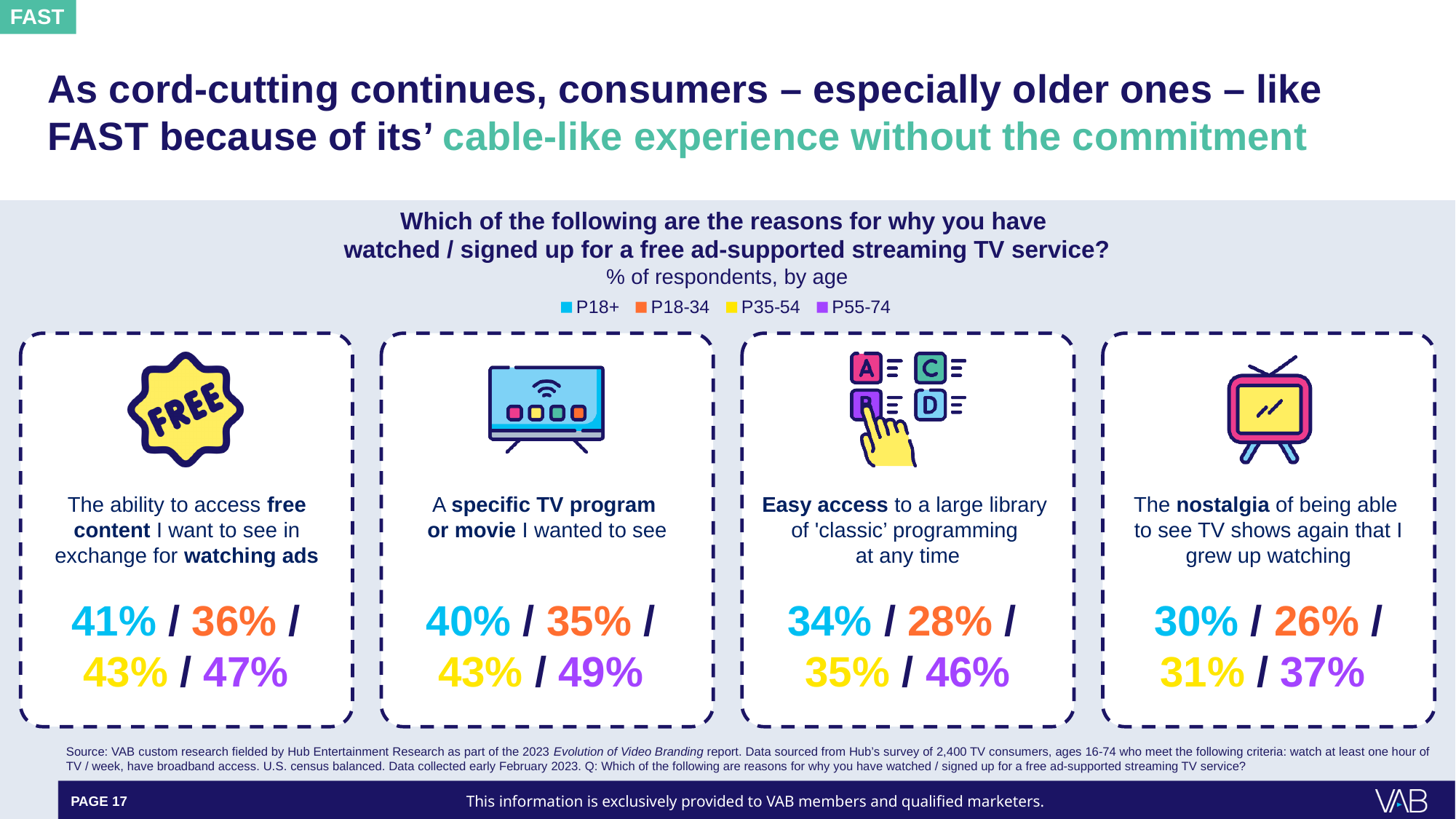
For the 'easy access to classic programming' reason, which age group has a higher percentage: P35-54 or P55-74? P55-74 Among P55-74 respondents, which reason has the highest percentage? A specific TV program or movie I wanted to see How many reasons for watching or signing up for a free ad-supported streaming TV service are shown? 4 Which age group is represented by the purple colour in the legend? P55-74 What percentage of P35-54 respondents cited the nostalgia of being able to see TV shows again that they grew up watching? 31% How many age groups does the legend list? 4 What percentage of P18-34 respondents cited easy access to a large library of 'classic' programming at any time? 28% What percentage of P18+ respondents cited a specific TV program or movie they wanted to see? 40% What percentage of P55-74 respondents cited the ability to access free content in exchange for watching ads as a reason? 47% For the 'specific TV program or movie' reason, what is the difference between the P55-74 and P18-34 percentages? 14 percentage points For the 'free content in exchange for watching ads' reason, what is the difference between the P18+ and P18-34 percentages? 5 percentage points Among P18-34 respondents, which reason has the lowest percentage? The nostalgia of being able to see TV shows again that I grew up watching